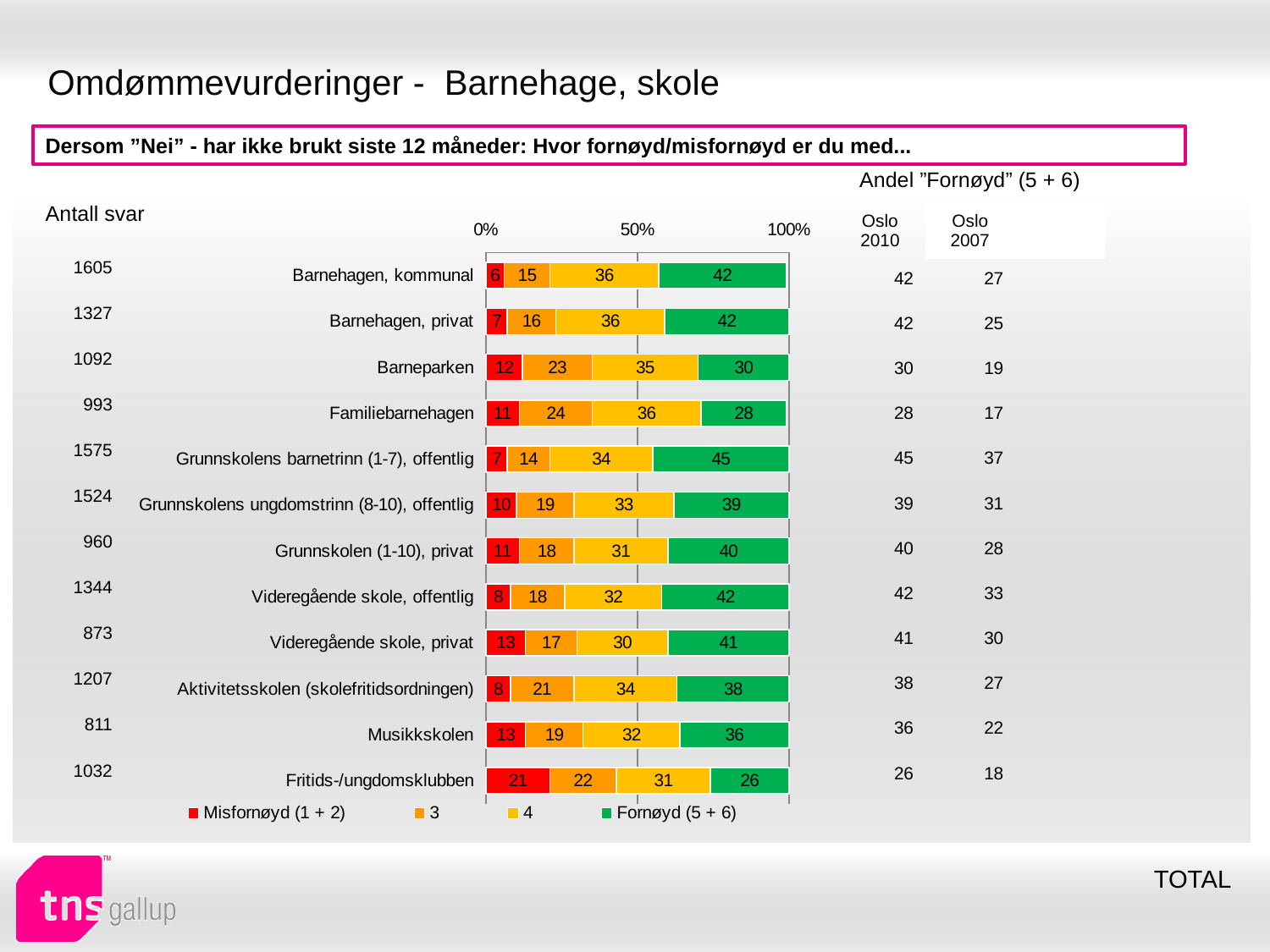
How many series does the chart legend list? 4 What is the value of "Fornøyd (5 + 6)" for Barnehagen, kommunal? 42 How many categories (rows) are plotted in the chart? 12 What is the total of the stacked bar for Barneparken? 100 What is the value of "Misfornøyd (1 + 2)" for Fritids-/ungdomsklubben? 21 What is the value of series "3" for Familiebarnehagen? 24 Which has a larger "Fornøyd (5 + 6)" value: Barneparken or Musikkskolen? Musikkskolen Which category has the highest "Fornøyd (5 + 6)" value? Grunnskolens barnetrinn (1-7), offentlig Which category has the lowest "Fornøyd (5 + 6)" value? Fritids-/ungdomsklubben Which category has the lowest "Misfornøyd (1 + 2)" value? Barnehagen, kommunal What type of chart is shown on the slide? Stacked bar chart What is the difference between the "Fornøyd (5 + 6)" values for Grunnskolens barnetrinn (1-7), offentlig and Fritids-/ungdomsklubben? 19